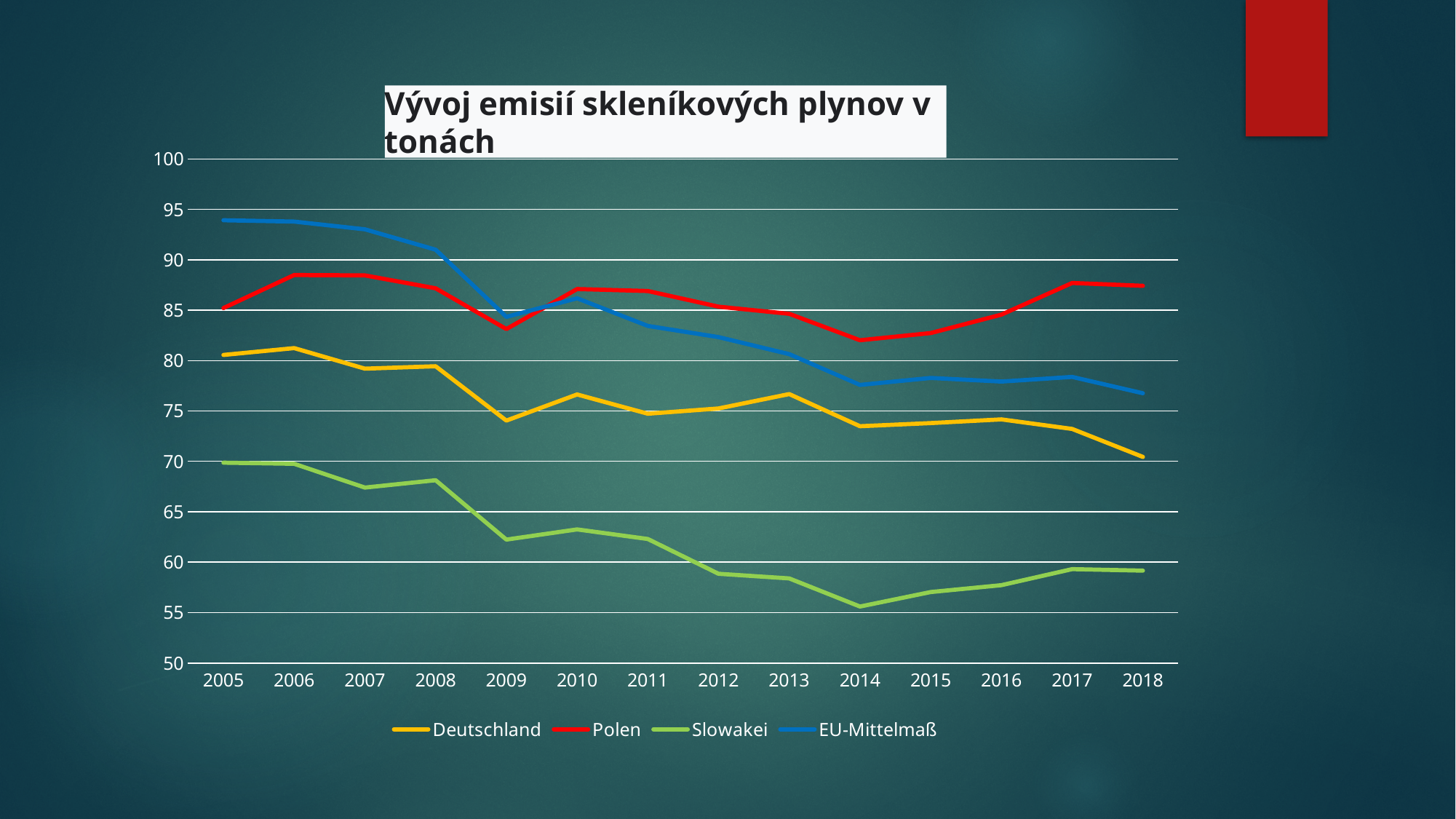
In which year does the Slowakei series reach its lowest value? 2014 What kind of chart is shown on the slide? line chart How many series does the legend list? 4 Which series has the lowest value in 2018? Slowakei Which is larger in 2018, the value for Polen or the value for Deutschland? Polen How many years are shown on the x axis? 14 What is the title of the chart? Vývoj emisií skleníkových plynov v tonách Is the value for Polen in 2009 greater or less than 85? less Is the value for EU-Mittelmaß in 2005 greater or less than 90? greater Is the value for Slowakei in 2014 greater or less than 60? less Which series has the highest value in 2005? EU-Mittelmaß Which is larger in 2018, the value for EU-Mittelmaß or the value for Polen? Polen